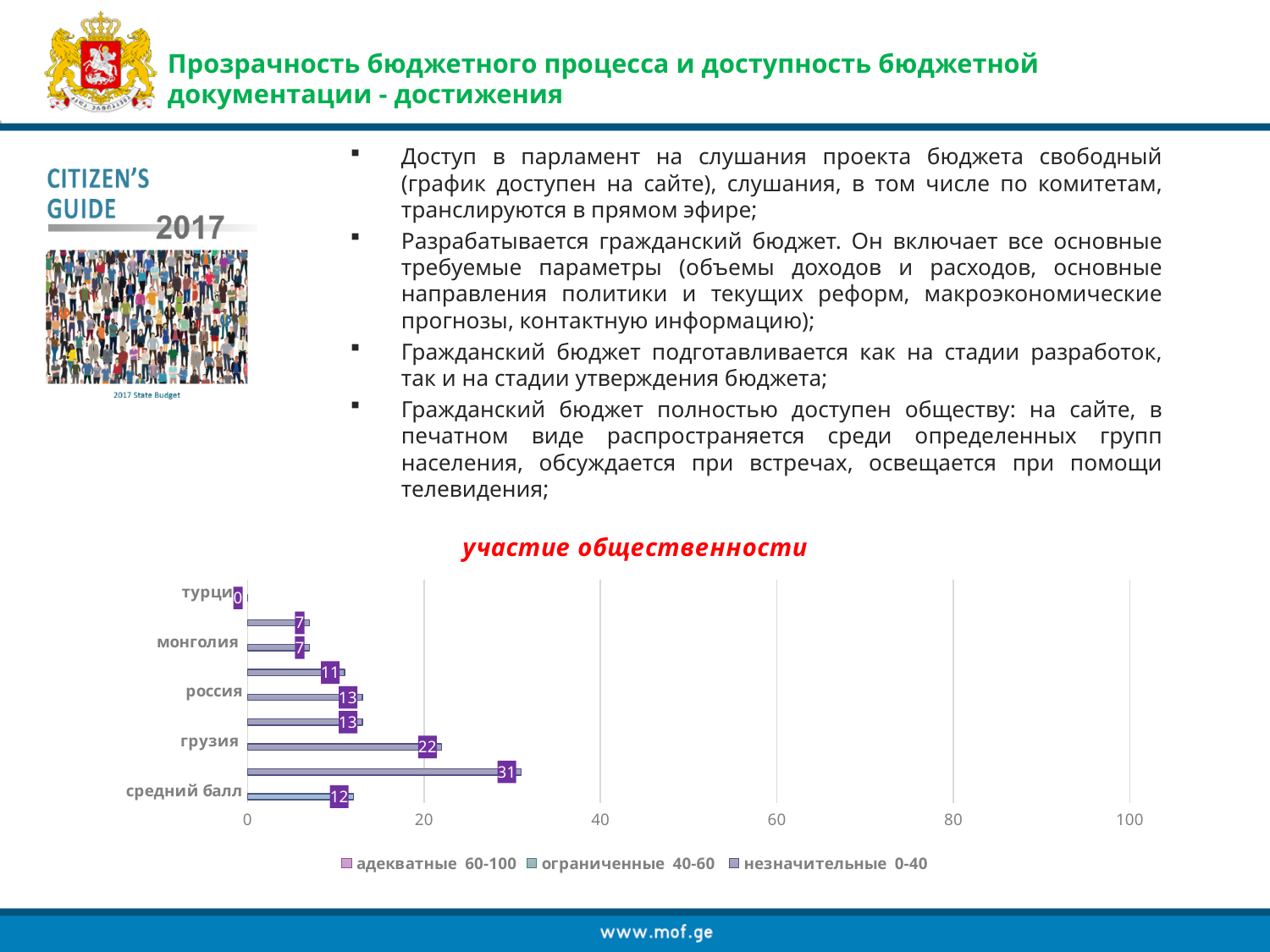
Which labelled category has the lowest value in the chart? турция What is the value for турция in the chart? 0 How many entries does the chart legend list? 3 What is the difference between the values for грузия and россия? 9 What is the value for средний балл in the chart? 12 What is the value for россия in the chart? 13 What is the value for грузия in the chart? 22 What is the value for монголия in the chart? 7 What is the largest value labelled on any bar in the chart? 31 Which is larger, the value for грузия or the value for средний балл? грузия What is the title of the chart? участие общественности What type of chart is shown on the slide? bar chart